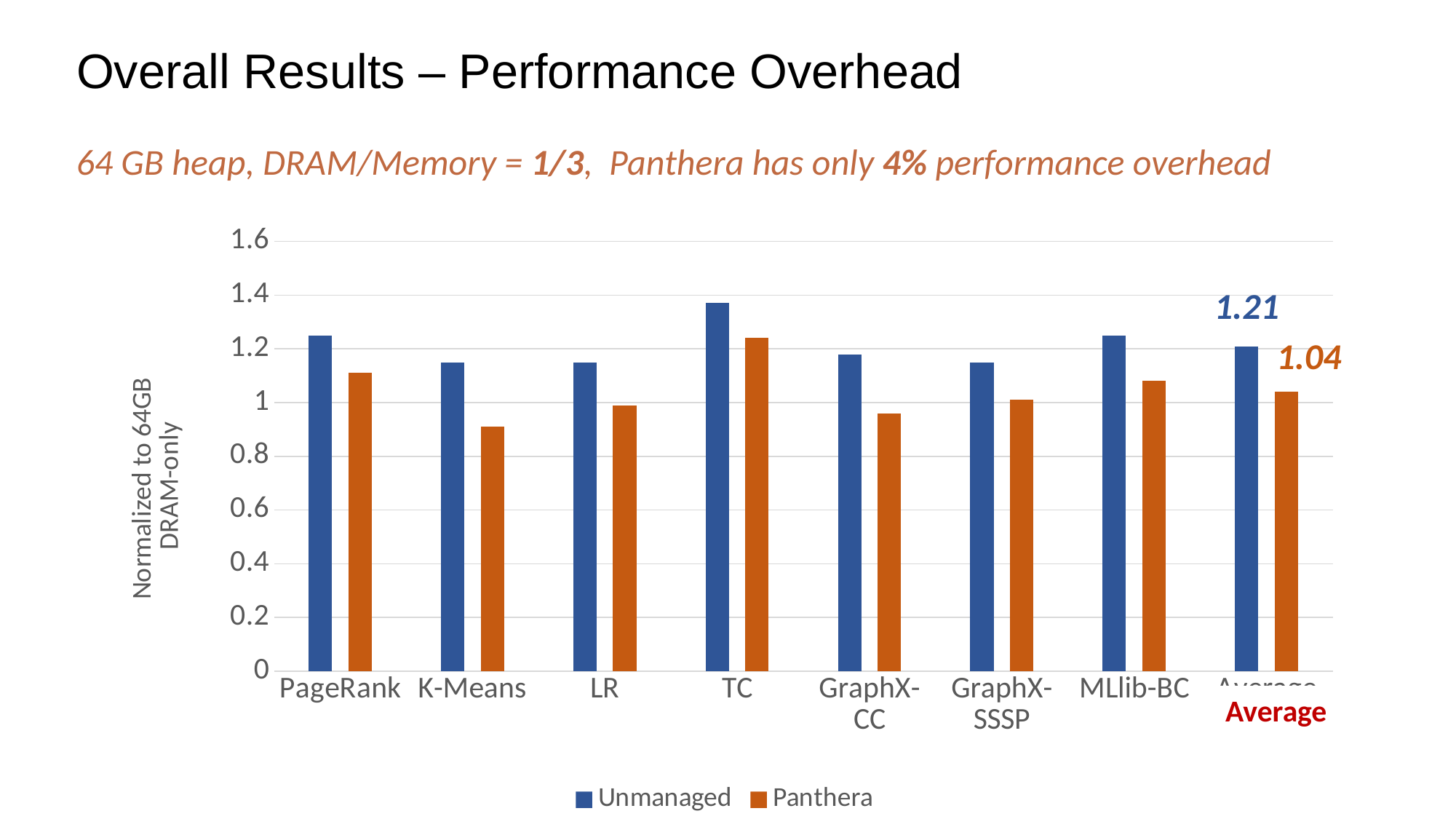
For TC, which series has the larger value, Unmanaged or Panthera? Unmanaged Which category has the lowest Panthera bar? K-Means What is the difference between the Unmanaged and Panthera values for Average? 0.17 Is the Panthera value for K-Means greater or less than 1? less Is the Panthera value for MLlib-BC greater or less than 1? greater What kind of chart is shown on the slide? Bar chart How many series does the legend list? 2 How many categories are shown on the x axis? 8 What is the Unmanaged value for Average? 1.21 What is the Panthera value for Average? 1.04 Which category has the highest Unmanaged bar? TC Is the Unmanaged value for TC greater or less than 1.2? greater